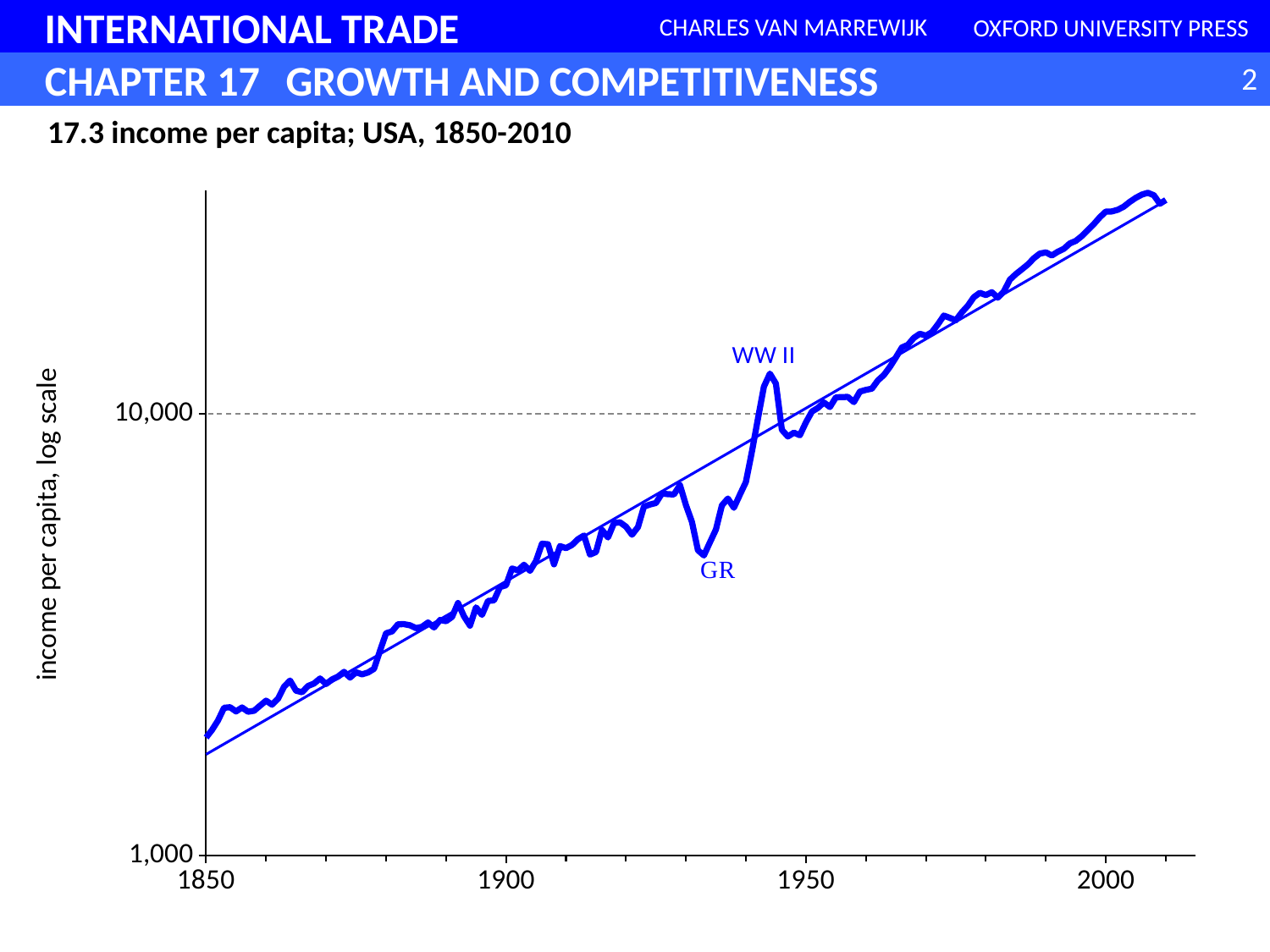
Is the value at the peak labelled WW II greater or less than 10,000? greater Is the value for 1850 greater or less than 1,000? greater Is the value for 1900 greater or less than 10,000? less Does income per capita generally rise or fall from 1850 to 2010? rise Which is larger, the value for 1950 or the value for 1900? 1950 What is the label of the vertical axis? income per capita, log scale Which is larger, the value for 1850 or the value for 2000? 2000 What kind of chart is shown on the slide? line chart What is the title of the chart on the slide? 17.3 income per capita; USA, 1850-2010 What is the first year shown on the horizontal axis? 1850